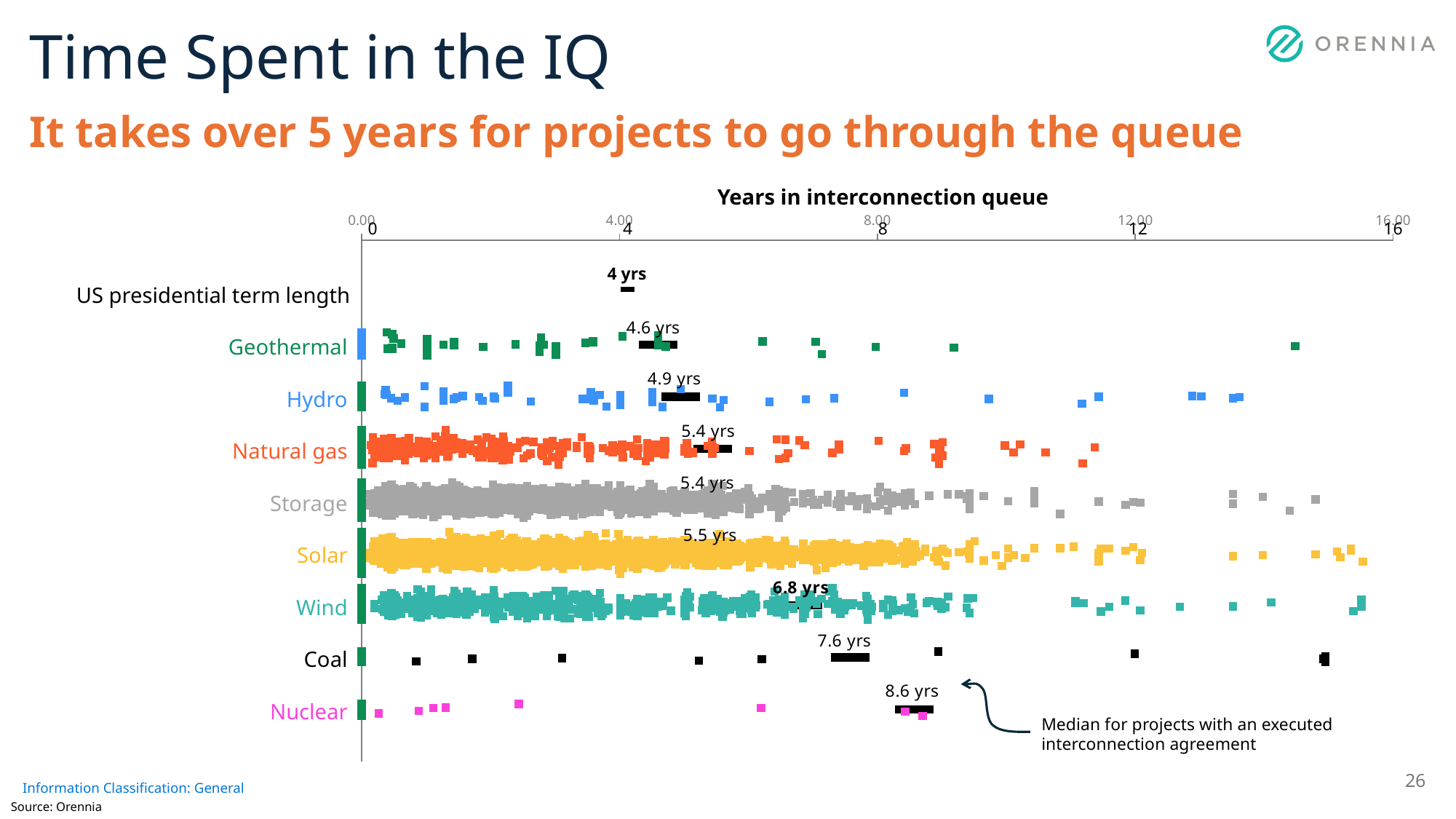
What is the median years in the interconnection queue for Coal projects? 7.6 yrs What is the median years in the interconnection queue for Wind projects? 6.8 yrs What is the difference between the median queue time for Coal and the US presidential term length? 3.6 yrs What is the title of the chart? Years in interconnection queue Which has a larger median queue time, Wind or Solar? Wind How much longer is the median queue time for Nuclear than for Hydro? 3.7 yrs Is the median queue time for Nuclear greater or less than 8 years? greater What is the median years in the interconnection queue for Geothermal projects? 4.6 yrs Which energy category has the lowest median time in the interconnection queue? Geothermal How many energy categories (excluding the US presidential term length reference) are shown on the chart? 8 Which energy category has the highest median time in the interconnection queue? Nuclear What is the median years in the interconnection queue for Nuclear projects? 8.6 yrs